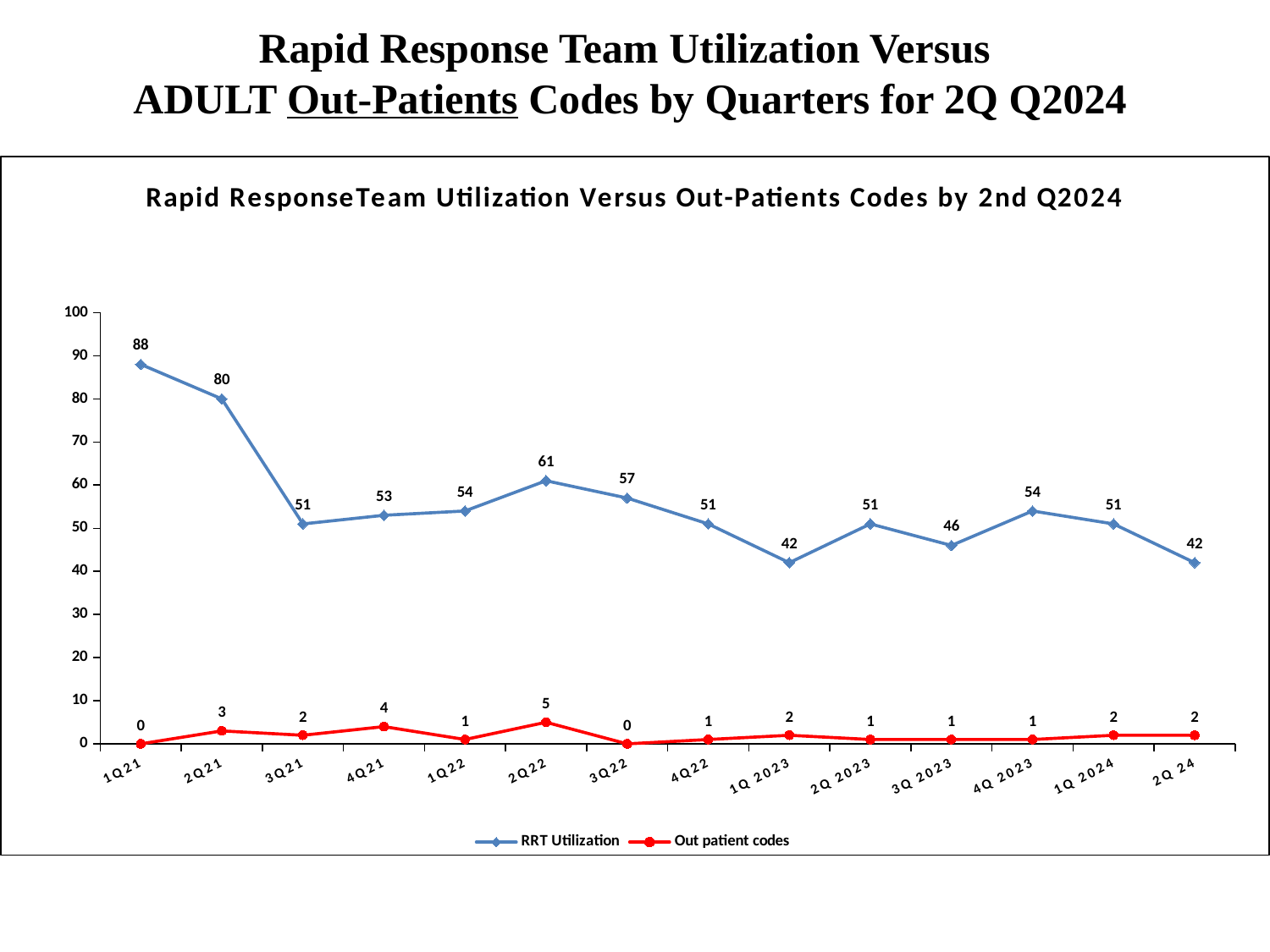
What is the difference between RRT Utilization in 1Q21 and 2Q21? 8 How many quarters are plotted along the x axis? 14 What is the RRT Utilization value for 1Q21? 88 Which is larger, RRT Utilization in 2Q22 or in 3Q22? 2Q22 What is the Out patient codes value for 2Q22? 5 What is the RRT Utilization value for 3Q 2023? 46 What type of chart is shown on the slide? line chart Overall, does RRT Utilization rise or fall from 1Q21 to 2Q 24? fall How many series does the legend list? 2 What colour is the Out patient codes line? red In which quarter are Out patient codes highest? 2Q22 In which quarter is RRT Utilization highest? 1Q21